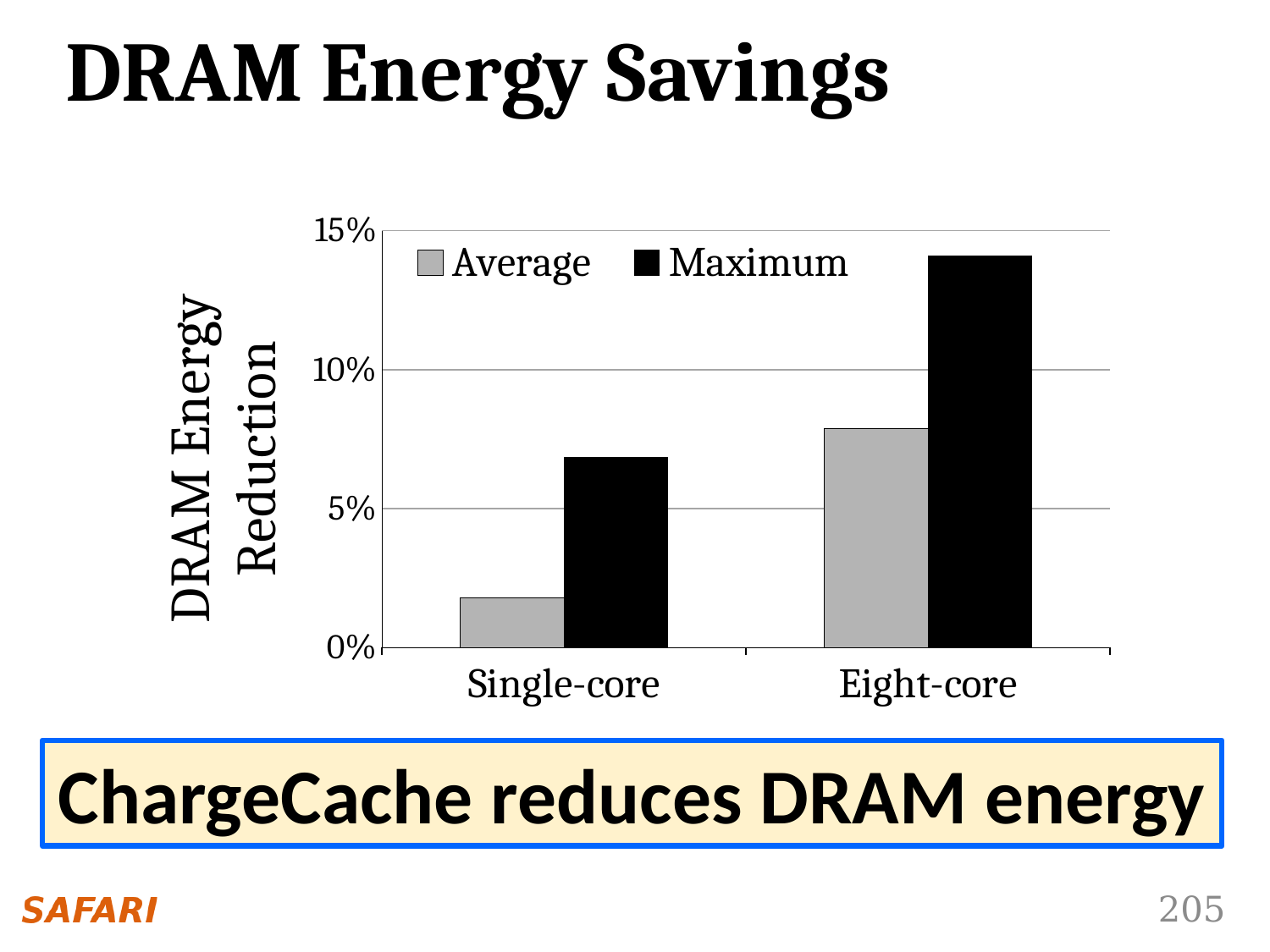
Is the Average value for Single-core greater or less than 5%? less How many series does the legend list? 2 How many categories are shown on the x axis? 2 Which is larger, the Maximum value for Single-core or the Maximum value for Eight-core? Eight-core Is the Maximum value for Single-core greater or less than 5%? greater What is the label on the y axis of the chart? DRAM Energy Reduction What kind of chart is shown on the slide? bar chart Is the Maximum value for Eight-core greater or less than 10%? greater Do the Average values rise or fall from Single-core to Eight-core? rise Which category and series has the lowest DRAM energy reduction? Single-core, Average Which category and series has the highest DRAM energy reduction? Eight-core, Maximum